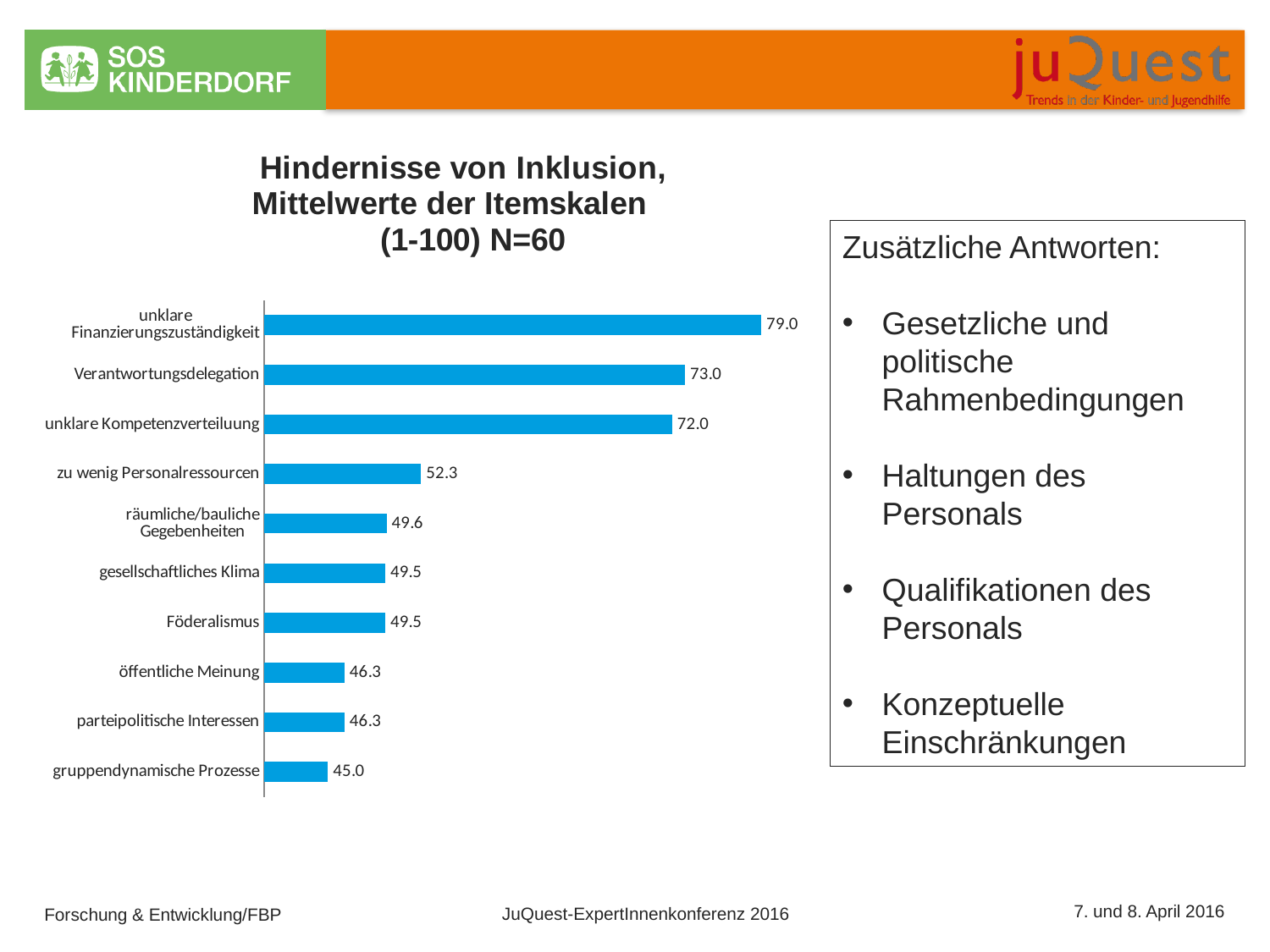
What is the value for "Verantwortungsdelegation"? 73.0 What is the value for "zu wenig Personalressourcen"? 52.3 What is the difference between the values for "unklare Finanzierungszuständigkeit" and "gruppendynamische Prozesse"? 34.0 Which category has the highest value? unklare Finanzierungszuständigkeit What is the value for "gruppendynamische Prozesse"? 45.0 What is the title of the chart? Hindernisse von Inklusion, Mittelwerte der Itemskalen (1-100) N=60 How many categories are shown in the chart? 10 Which category has the lowest value? gruppendynamische Prozesse What is the value for "unklare Finanzierungszuständigkeit"? 79.0 What is the difference between the values for "Verantwortungsdelegation" and "unklare Kompetenzverteiluung"? 1.0 What kind of chart is shown on the slide? bar chart Which is larger, the value for "zu wenig Personalressourcen" or the value for "öffentliche Meinung"? zu wenig Personalressourcen